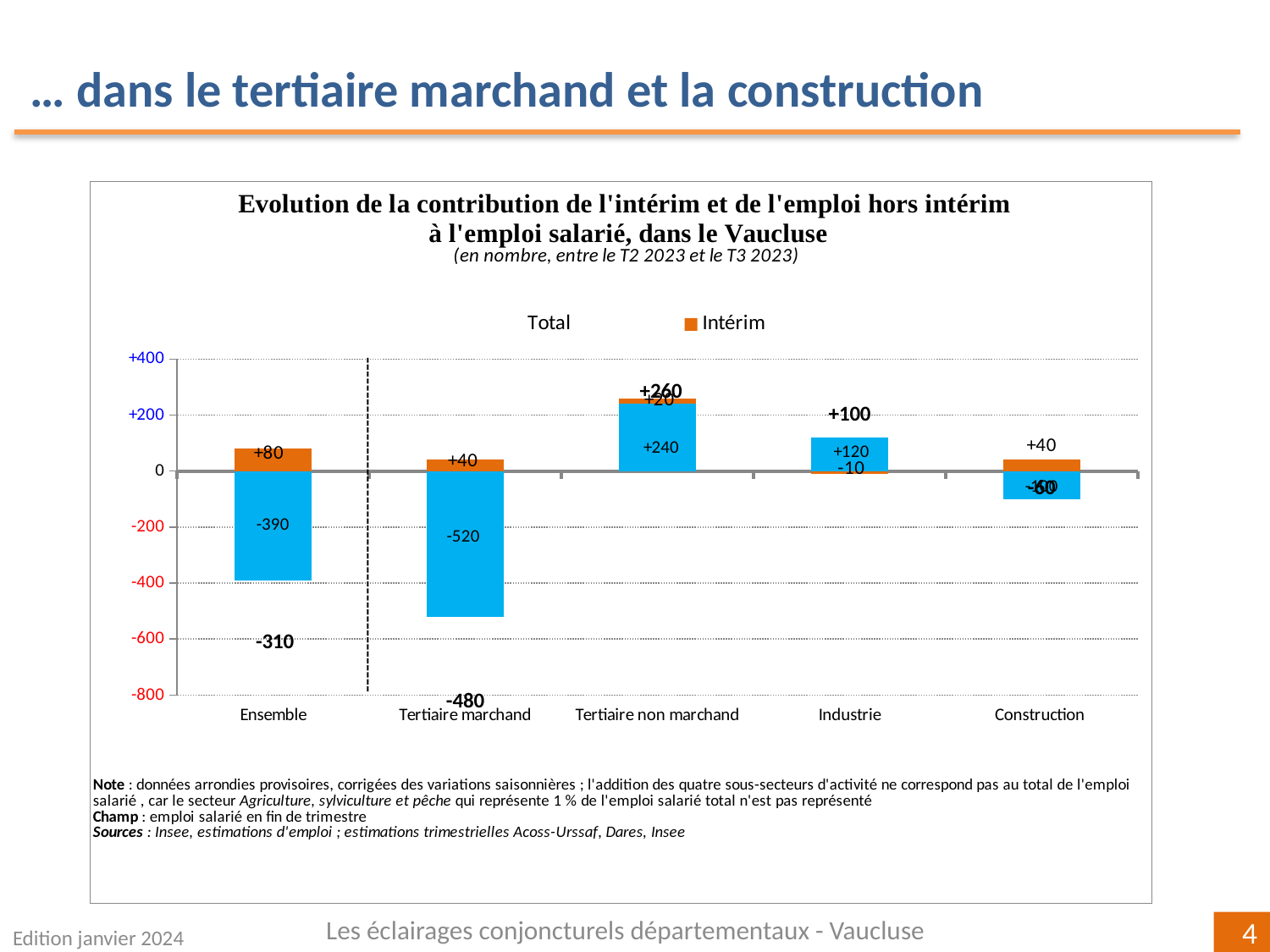
What is the Intérim value for Industrie? -10 Which category has the lowest Total value? Tertiaire marchand What kind of chart is shown on the slide? bar chart What is the Intérim value for Ensemble? +80 What is the Total value for Tertiaire non marchand? +260 What value is labelled on the blue bar for Tertiaire non marchand? +240 What is the Intérim value for Tertiaire marchand? +40 How many sector categories are shown on the x axis of the chart? 5 What is the Total value for Tertiaire marchand? -480 What is the difference between the Intérim value for Ensemble and the Intérim value for Tertiaire marchand? 40 What is the Total value for Ensemble? -310 Which category has the highest Total value? Tertiaire non marchand